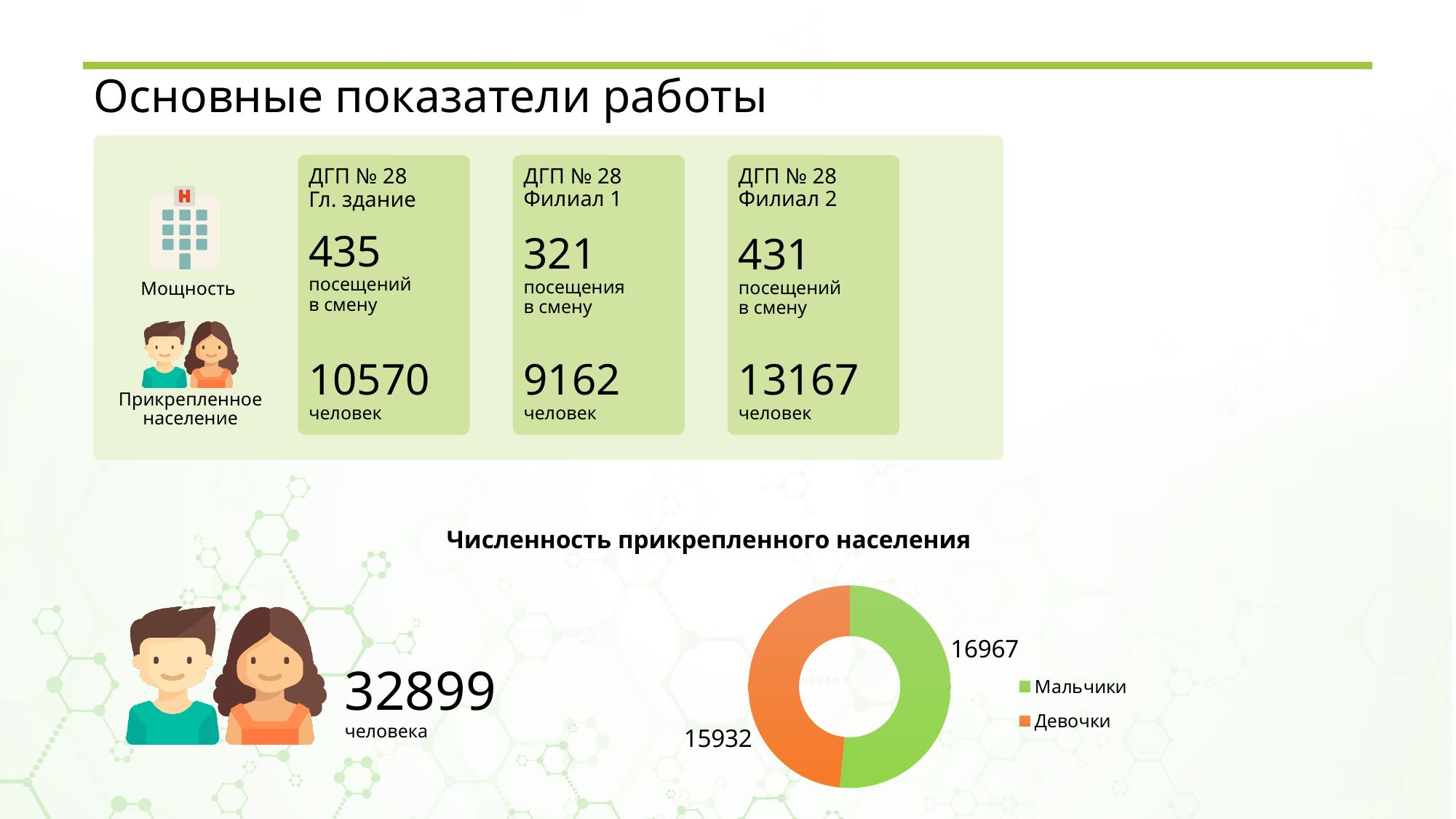
Which category has the smallest slice in the chart 'Численность прикрепленного населения'? Девочки Which is larger in the chart: Мальчики or Девочки? Мальчики What kind of chart is 'Численность прикрепленного населения'? Pie (donut) chart What is the difference between the values for Мальчики and Девочки in the chart? 1035 How many categories are shown in the chart 'Численность прикрепленного населения'? 2 What is the total of the two slices in the chart 'Численность прикрепленного населения'? 32899 What is the value for Мальчики in the chart 'Численность прикрепленного населения'? 16967 What is the value for Девочки in the chart 'Численность прикрепленного населения'? 15932 Which colour represents Девочки in the chart? Orange How many entries does the legend of the chart list? 2 Which category has the largest slice in the chart 'Численность прикрепленного населения'? Мальчики What is the title of the chart on the slide? Численность прикрепленного населения